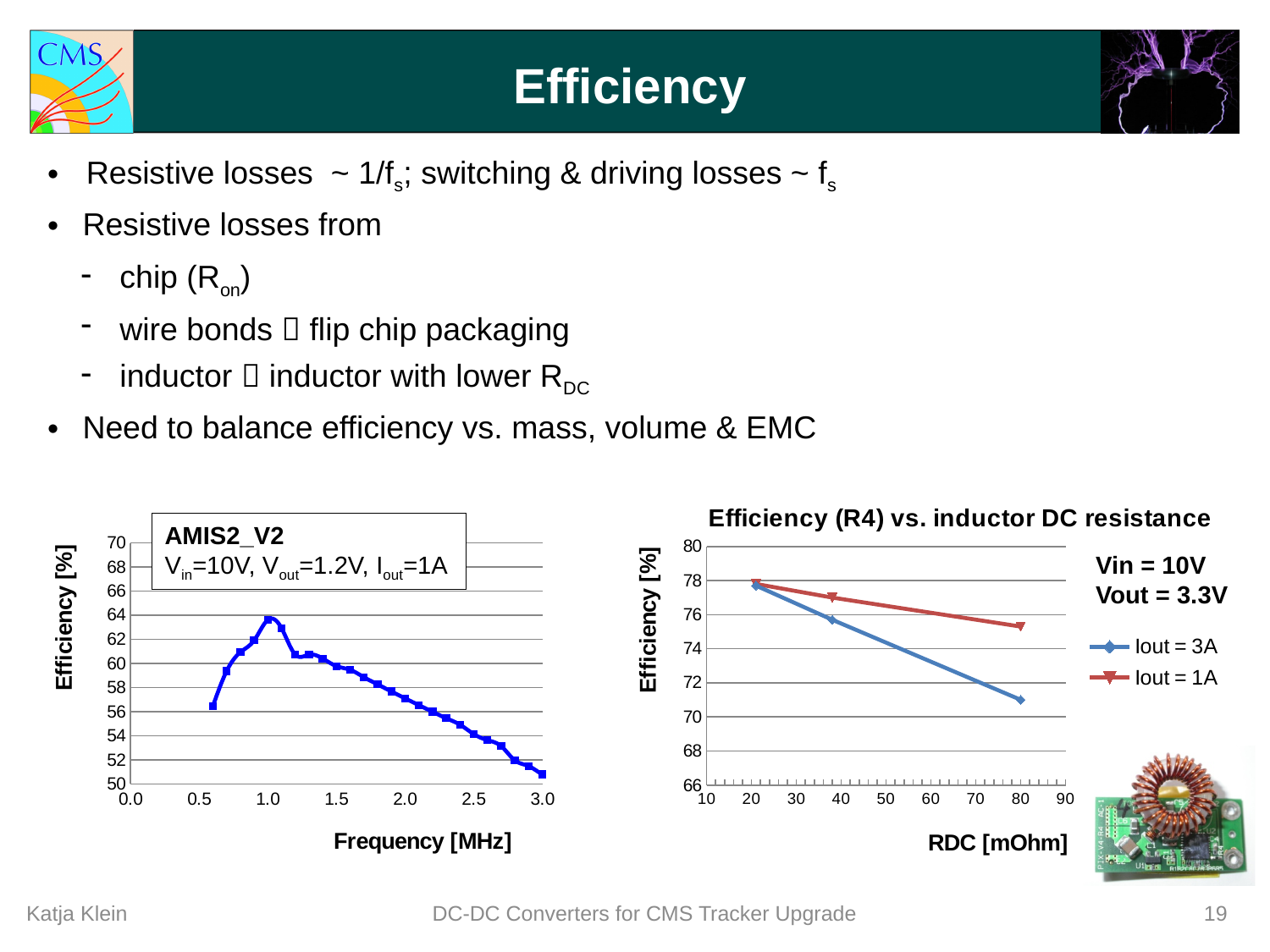
In the left chart (AMIS2_V2), what is the label of the x axis? Frequency [MHz] In the right chart (Efficiency (R4) vs. inductor DC resistance), is the efficiency of the Iout = 3A series at 80 mOhm greater or less than 72? less What kind of chart is the left chart (AMIS2_V2)? line chart In the right chart (Efficiency (R4) vs. inductor DC resistance), how many data points does the Iout = 3A series have? 3 How many series does the legend of the right chart (Efficiency (R4) vs. inductor DC resistance) list? 2 In the left chart (AMIS2_V2), is the efficiency at 1.0 MHz greater or less than 62? greater In the left chart (AMIS2_V2), is the efficiency at 0.6 MHz greater or less than 58? less What is the title of the right chart? Efficiency (R4) vs. inductor DC resistance In the left chart (AMIS2_V2), does the efficiency rise or fall as frequency increases from 1.0 MHz to 3.0 MHz? fall In the right chart (Efficiency (R4) vs. inductor DC resistance), does the efficiency of the Iout = 3A series rise or fall as RDC increases? fall In the right chart (Efficiency (R4) vs. inductor DC resistance), which series has the higher efficiency at RDC = 80 mOhm, Iout = 3A or Iout = 1A? Iout = 1A